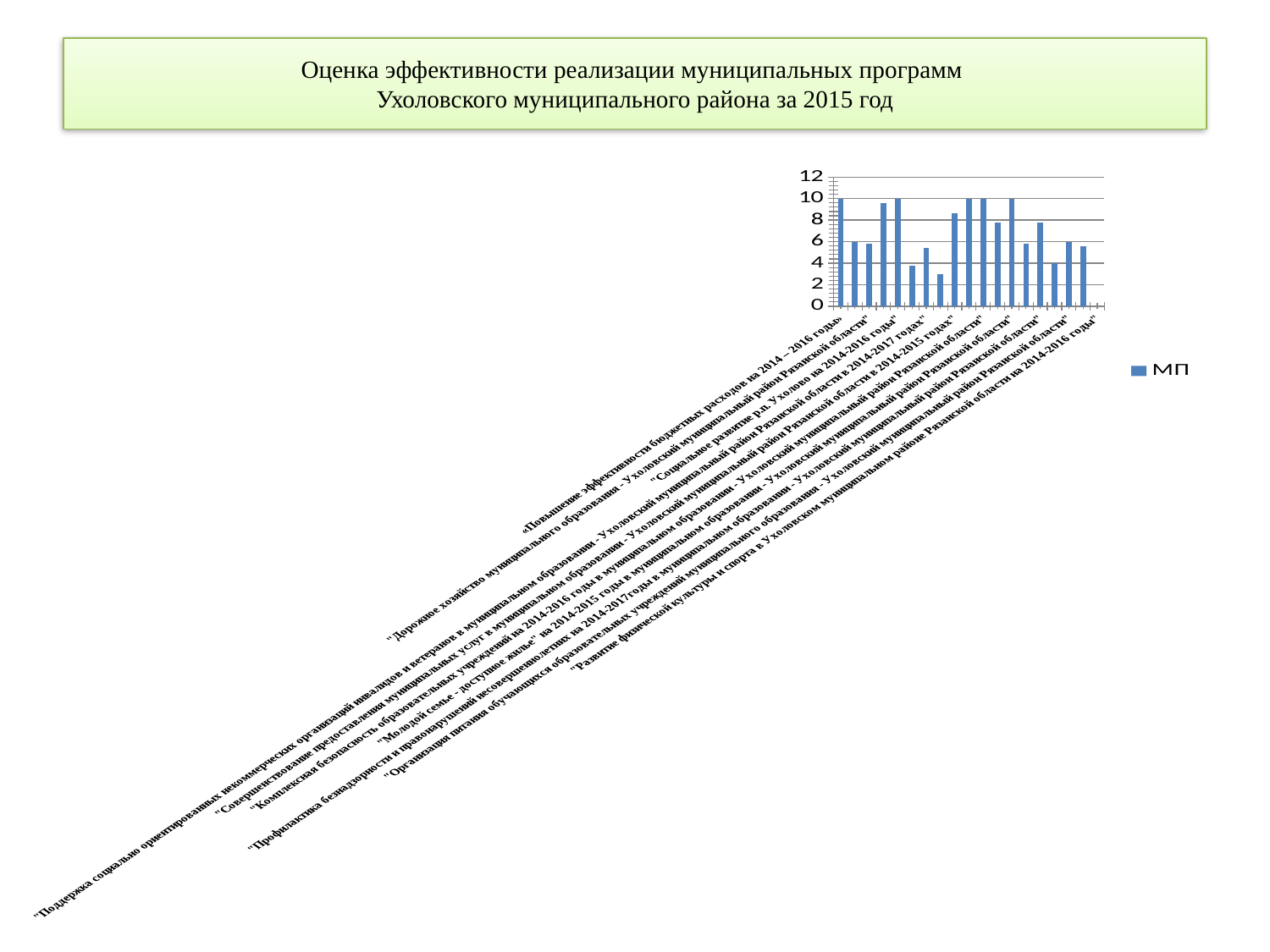
Is the value of the second bar from the left greater or less than 8? less What is the highest value shown on the chart's vertical axis? 12 What kind of chart is shown on the slide? bar chart Is the value of the first bar from the left greater or less than 8? greater What is the name of the series shown in the chart legend? МП Which bar has the lowest value on the chart? the eighth bar from the left Which is larger, the sixth bar from the left or the ninth bar from the left? the ninth bar Is the value of the last bar on the right greater or less than 8? less Which is larger, the first bar from the left or the second bar from the left? the first bar How many series does the chart legend list? 1